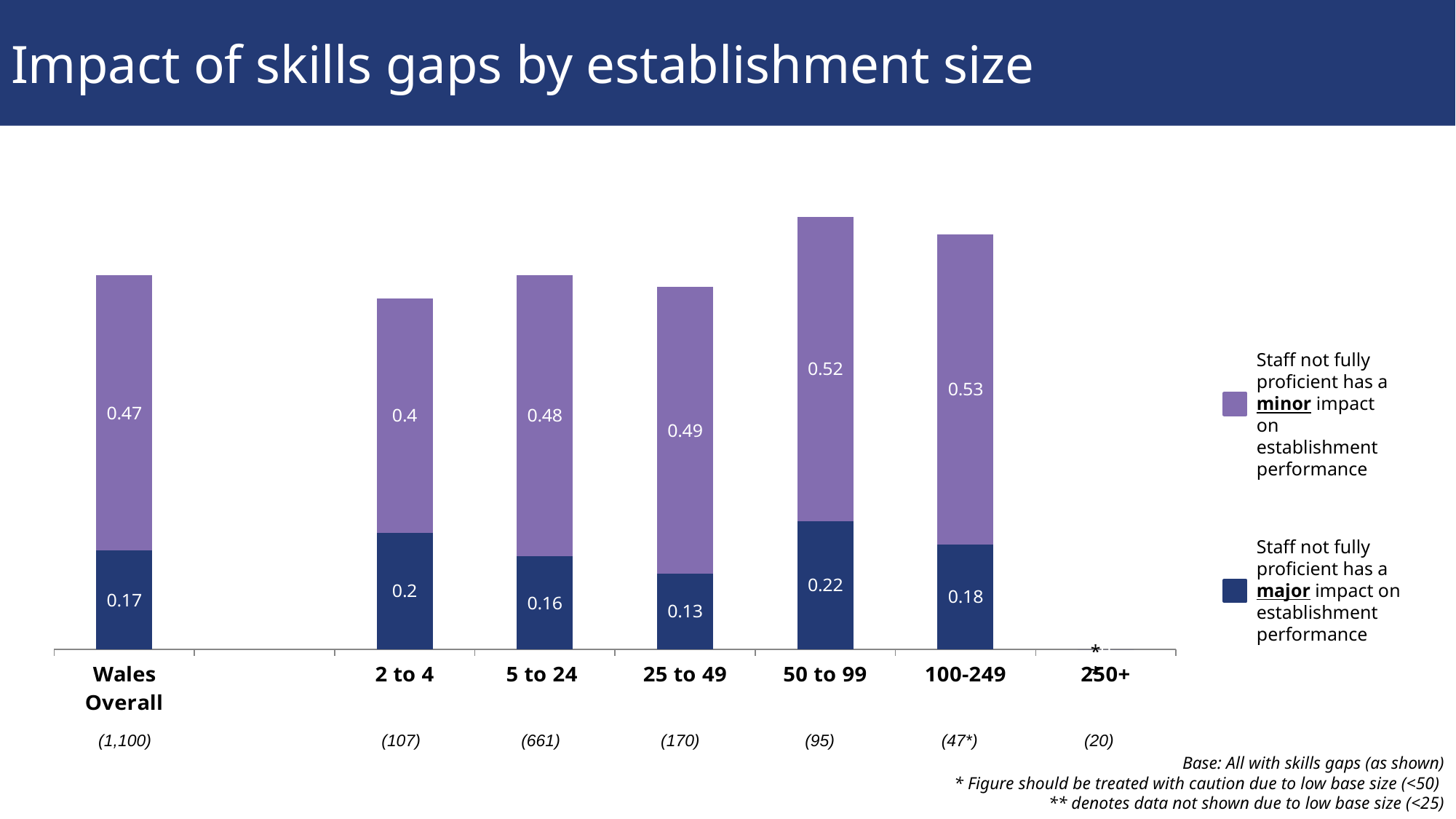
Which establishment size has the lowest 'minor impact' value? 2 to 4 What is the value for 'minor impact' for Wales Overall? 0.47 Which is larger: the 'major impact' value for 2 to 4 or for 5 to 24? 2 to 4 What is the value for 'minor impact' for the 2 to 4 establishment size? 0.4 Which establishment size has the highest 'major impact' value? 50 to 99 What is the difference between the 'minor impact' values for 100-249 and 2 to 4? 0.13 Which establishment size has the lowest 'major impact' value? 25 to 49 What is the total of the stacked bar for Wales Overall? 0.64 How many series does the legend list? 2 What type of chart is shown on the slide? Stacked bar chart What is the value for 'major impact' for the 50 to 99 establishment size? 0.22 What is the total of the stacked bar for the 50 to 99 establishment size? 0.74